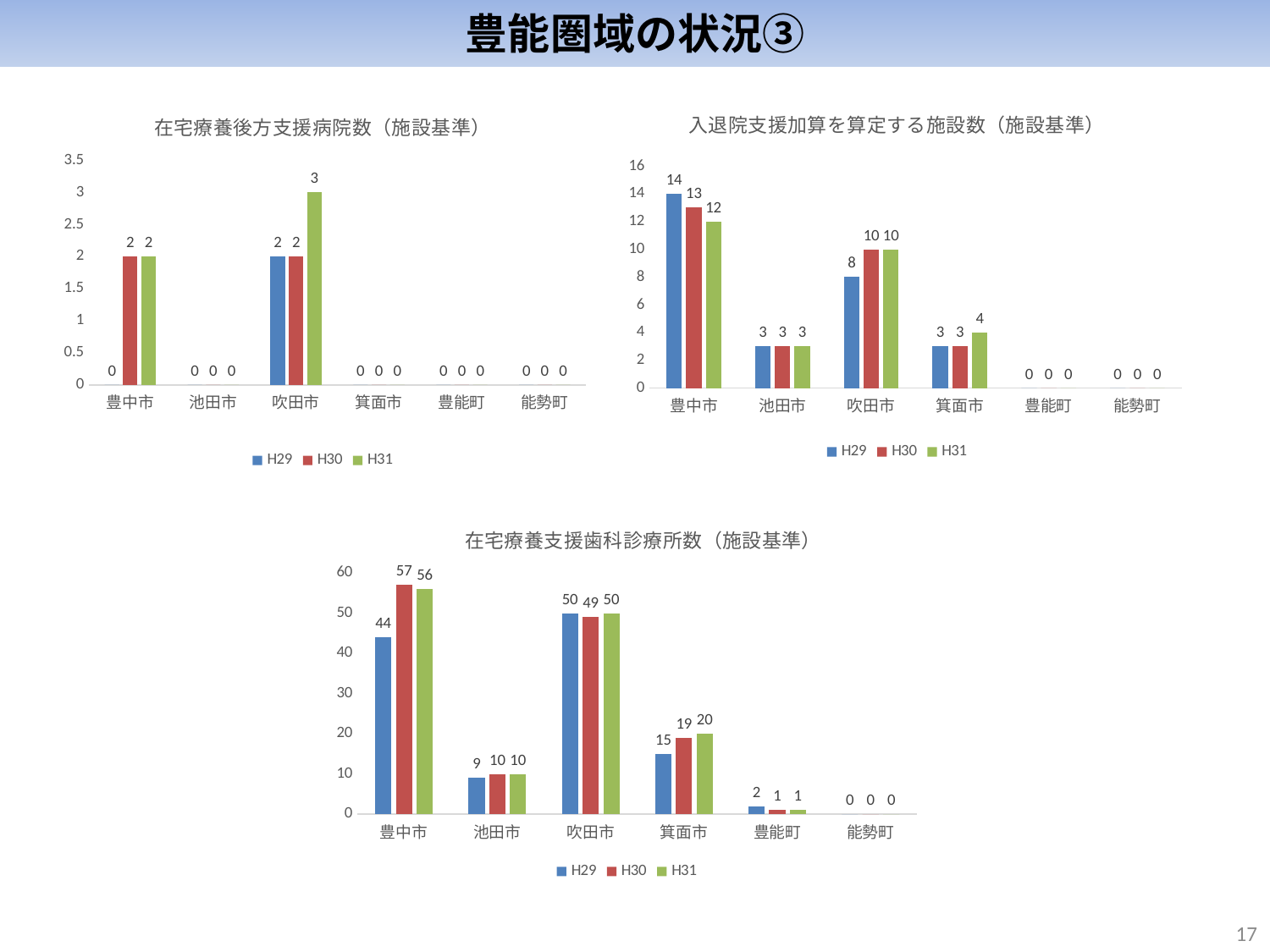
In the bottom chart titled 在宅療養支援歯科診療所数（施設基準）, how many categories are shown on the x axis? 6 In the bottom chart titled 在宅療養支援歯科診療所数（施設基準）, which is larger for H29: 豊中市 or 吹田市? 吹田市 In the top-right chart titled 入退院支援加算を算定する施設数（施設基準）, which category has the highest H31 value? 豊中市 What type of chart is the top-right chart titled 入退院支援加算を算定する施設数（施設基準）? bar chart How many series does the legend of the bottom chart titled 在宅療養支援歯科診療所数（施設基準） list? 3 In the bottom chart titled 在宅療養支援歯科診療所数（施設基準）, what is the H30 value for 豊中市? 57 In the top-left chart titled 在宅療養後方支援病院数（施設基準）, what is the H31 value for 吹田市? 3 In the top-right chart titled 入退院支援加算を算定する施設数（施設基準）, what is the difference between the H30 and H29 values for 吹田市? 2 In the top-right chart titled 入退院支援加算を算定する施設数（施設基準）, what is the H29 value for 豊中市? 14 In the top-right chart titled 入退院支援加算を算定する施設数（施設基準）, do the values for 豊中市 rise or fall from H29 to H31? fall In the top-left chart titled 在宅療養後方支援病院数（施設基準）, what is the H29 value for 豊中市? 0 In the bottom chart titled 在宅療養支援歯科診療所数（施設基準）, what is the difference between the H31 values for 吹田市 and 箕面市? 30